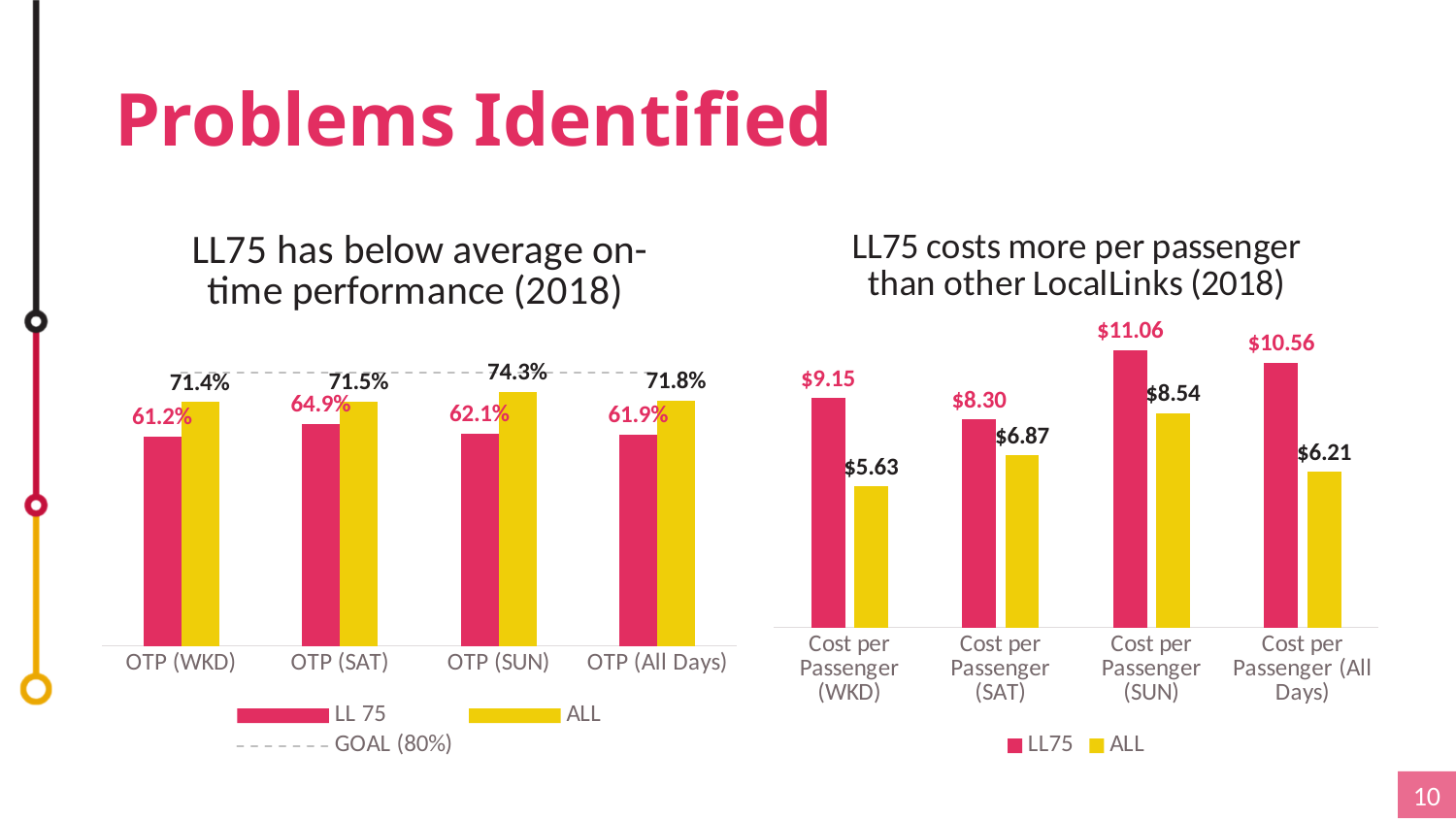
What kind of chart is the cost per passenger chart? Bar chart In the on-time performance chart, which category has the lowest LL 75 value? OTP (WKD) In the on-time performance chart, what goal level does the dashed line represent? 80% In the cost per passenger chart, which category has the lowest ALL value? Cost per Passenger (WKD) In the cost per passenger chart, which is larger: the LL75 value for Cost per Passenger (SAT) or the ALL value for Cost per Passenger (SUN)? ALL value for Cost per Passenger (SUN) In the cost per passenger chart, what is the ALL value for Cost per Passenger (WKD)? $5.63 In the on-time performance chart, what is the LL 75 value for OTP (SAT)? 64.9% In the on-time performance chart, which category has the highest ALL value? OTP (SUN) In the on-time performance chart, what is the ALL value for OTP (SUN)? 74.3% In the cost per passenger chart, what is the LL75 value for Cost per Passenger (SUN)? $11.06 In the cost per passenger chart, what is the difference between the LL75 and ALL values for Cost per Passenger (All Days)? $4.35 In the on-time performance chart, what is the difference between the ALL and LL 75 values for OTP (WKD)? 10.2%